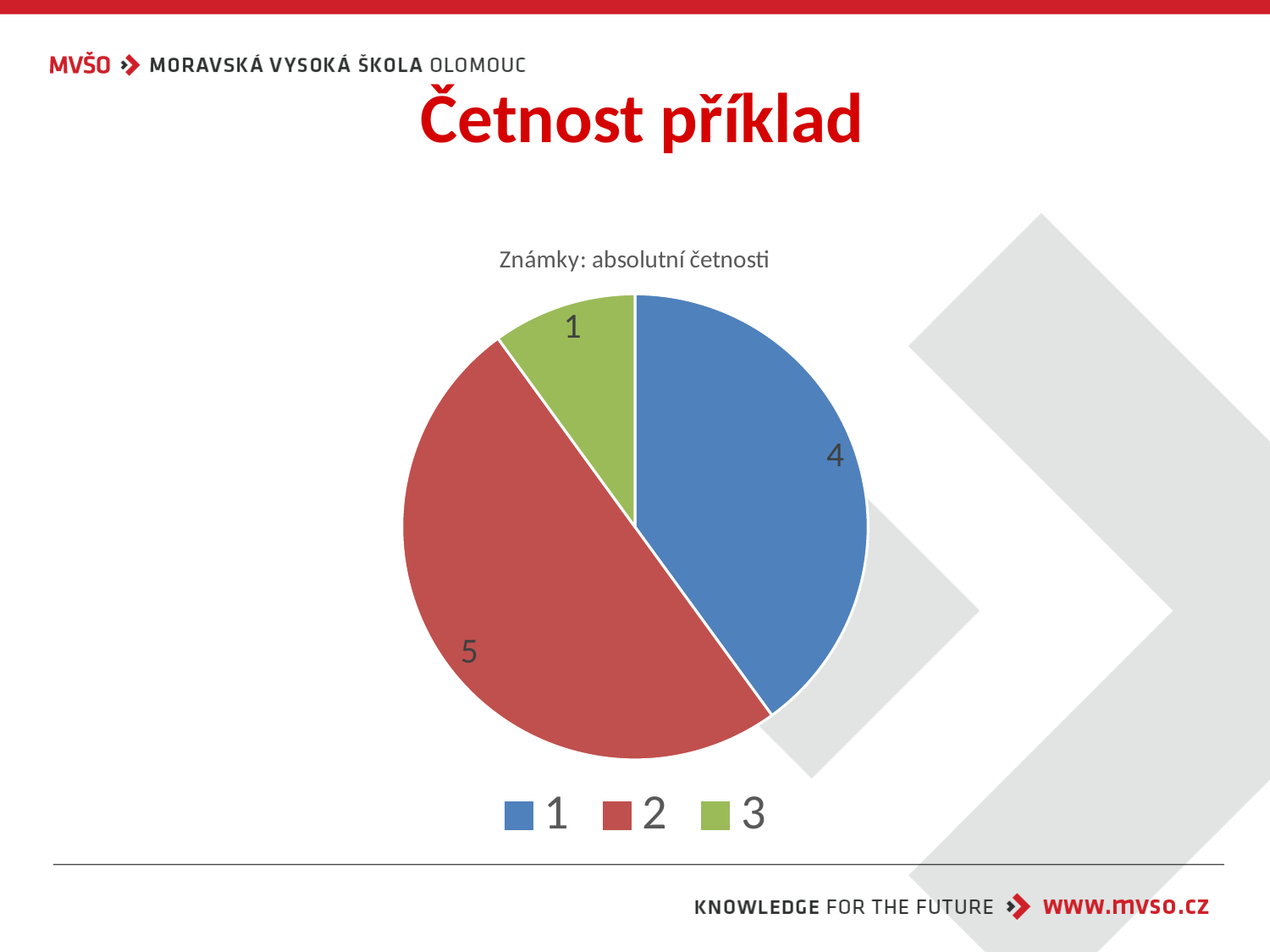
What is the value for category 2? 5 What is the difference between the values for category 2 and category 1? 1 What is the value for category 3? 1 What is the value for category 1? 4 What share of the pie does category 2 represent? 50% How many entries does the legend list? 3 How many slices does the pie chart have? 3 What kind of chart is shown on the slide? pie chart Which category has the smallest slice? 3 Which is larger, the value for category 1 or category 3? 1 What is the title of the chart? Známky: absolutní četnosti Which category has the largest slice? 2